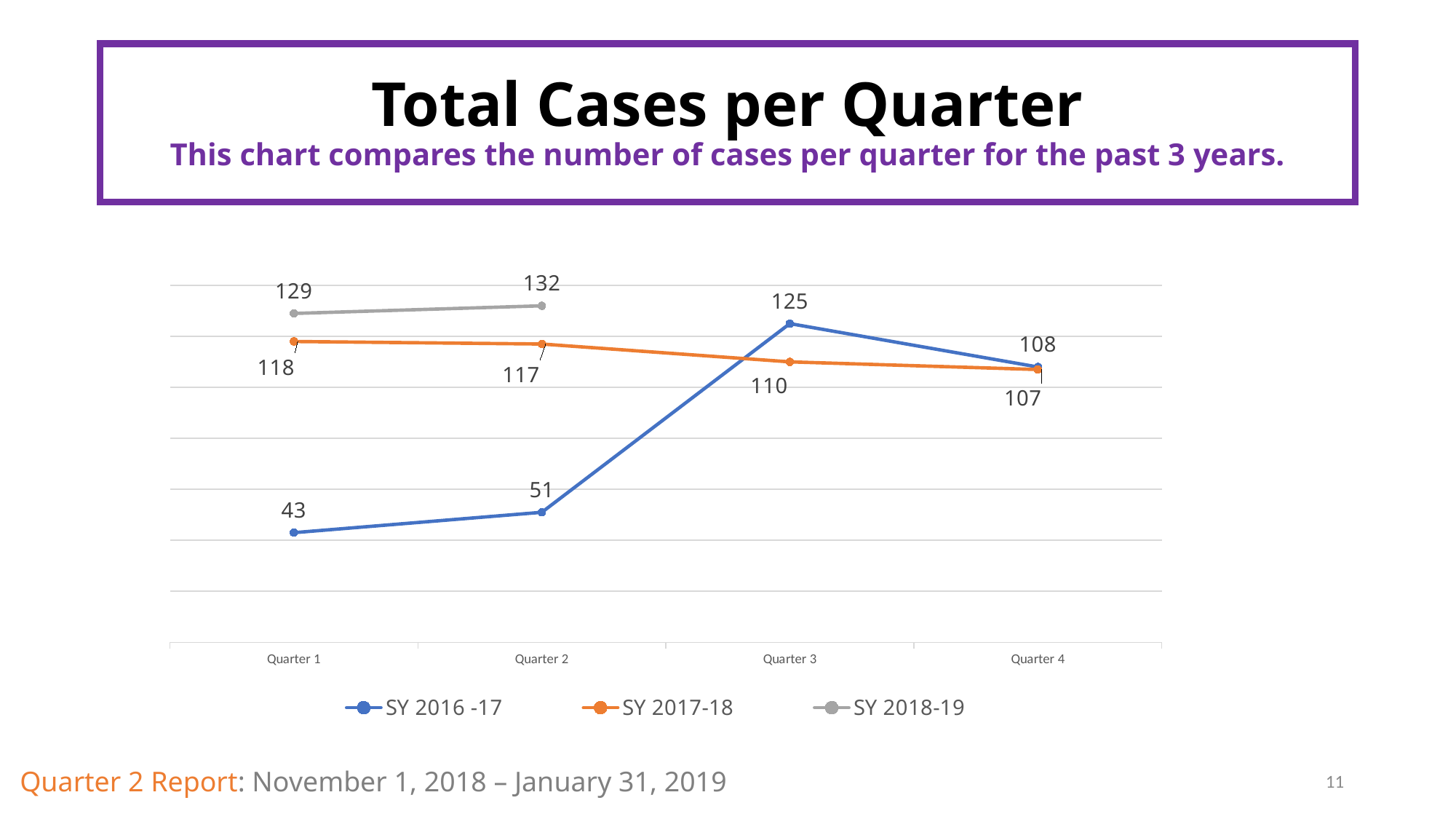
In which quarter does SY 2016 -17 reach its highest value? Quarter 3 What is the title of the chart? Total Cases per Quarter In which quarter does SY 2017-18 have its lowest value? Quarter 4 How many series does the legend list? 3 What is the value for SY 2016 -17 in Quarter 1? 43 Which is larger in Quarter 1: SY 2017-18 or SY 2018-19? SY 2018-19 What is the value for SY 2018-19 in Quarter 2? 132 What is the value for SY 2017-18 in Quarter 3? 110 Does the SY 2017-18 line rise or fall from Quarter 1 to Quarter 4? Fall What kind of chart is shown on the slide? Line chart How many quarters are shown on the x axis? 4 What is the difference between the SY 2016 -17 values in Quarter 3 and Quarter 2? 74